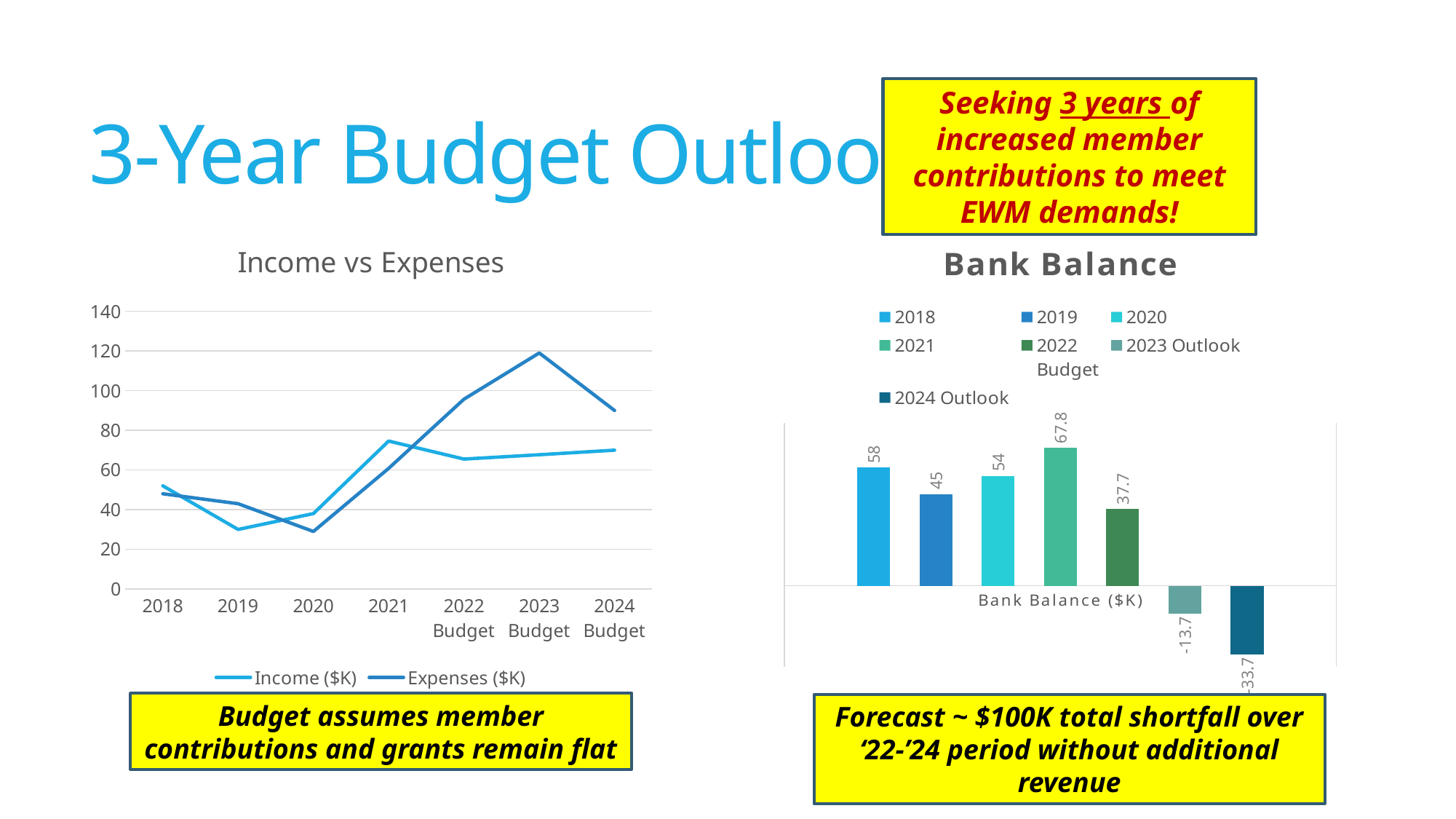
In the Bank Balance chart, which is larger, the value for 2020 or the value for 2022 Budget? 2020 How many series does the legend of the Bank Balance chart list? 7 In the Income vs Expenses chart, which is larger in 2023 Budget, Income ($K) or Expenses ($K)? Expenses ($K) In the Bank Balance chart, what is the value for 2024 Outlook? -33.7 In the Bank Balance chart, what is the value for 2021? 67.8 In the Bank Balance chart, which year has the lowest bank balance? 2024 Outlook In the Income vs Expenses chart, is the Expenses ($K) value for 2023 Budget greater or less than 100? greater In the Bank Balance chart, which year has the highest bank balance? 2021 What kind of chart is the Bank Balance chart? Bar chart How many years are shown on the x axis of the Income vs Expenses chart? 7 What kind of chart is the Income vs Expenses chart? Line chart In the Bank Balance chart, what is the difference between the 2018 value and the 2019 value? 13